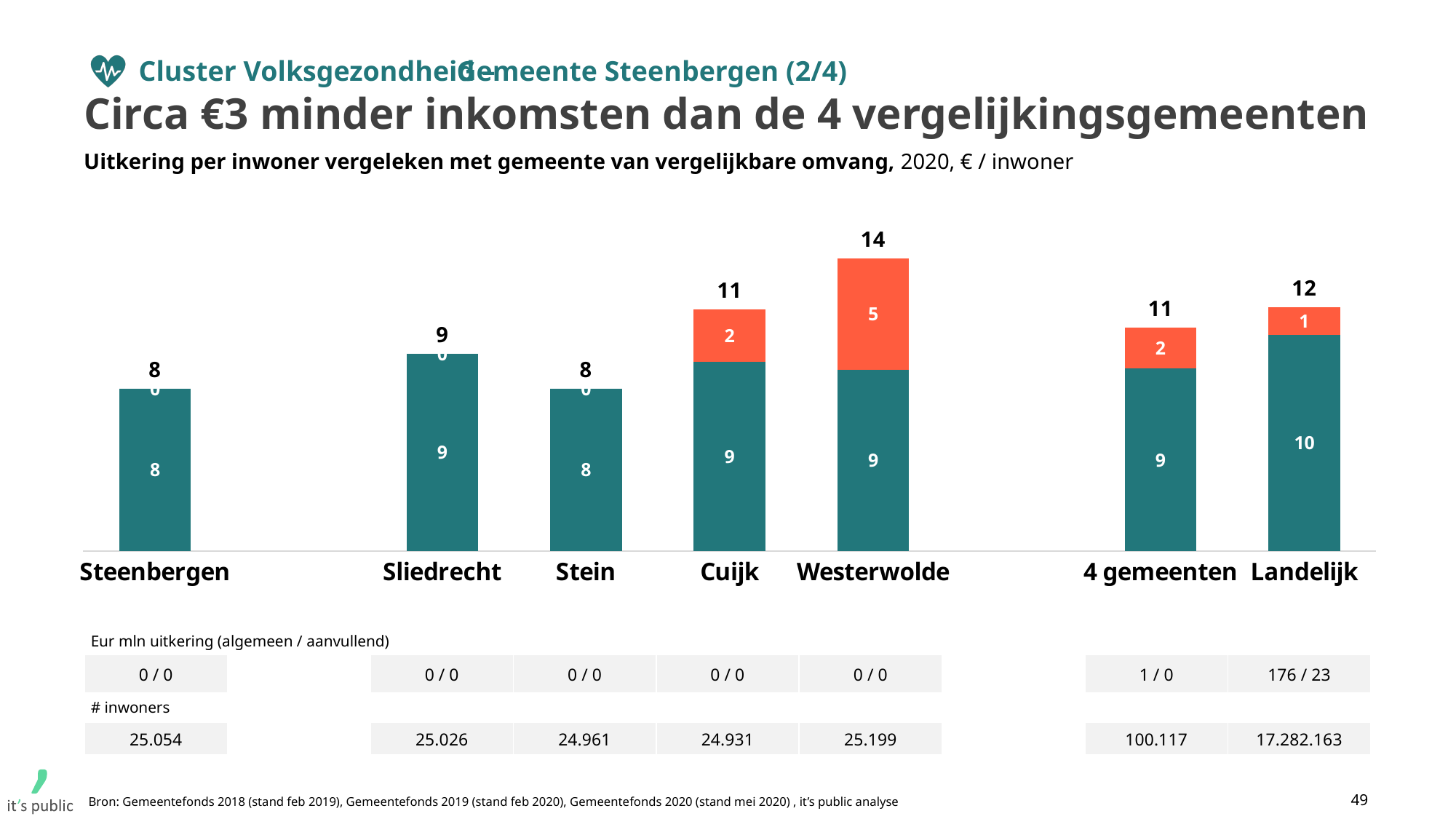
What is the value of the teal (bottom) segment for Landelijk? 10 What is the total value shown above the bar for Steenbergen? 8 What unit is stated in the chart subtitle for the values plotted? € / inwoner What kind of chart is shown on the slide? Stacked bar chart What is the difference between the total for Westerwolde and the total for Steenbergen? 6 How many categories are shown on the x axis of the chart? 7 What is the value of the orange (top) segment for Cuijk? 2 Which category has the highest total value? Westerwolde What is the total value shown above the bar for Westerwolde? 14 Which is larger, the total for Landelijk or the total for 4 gemeenten? Landelijk What is the total value shown above the bar for Sliedrecht? 9 What is the value of the orange (top) segment for Westerwolde? 5